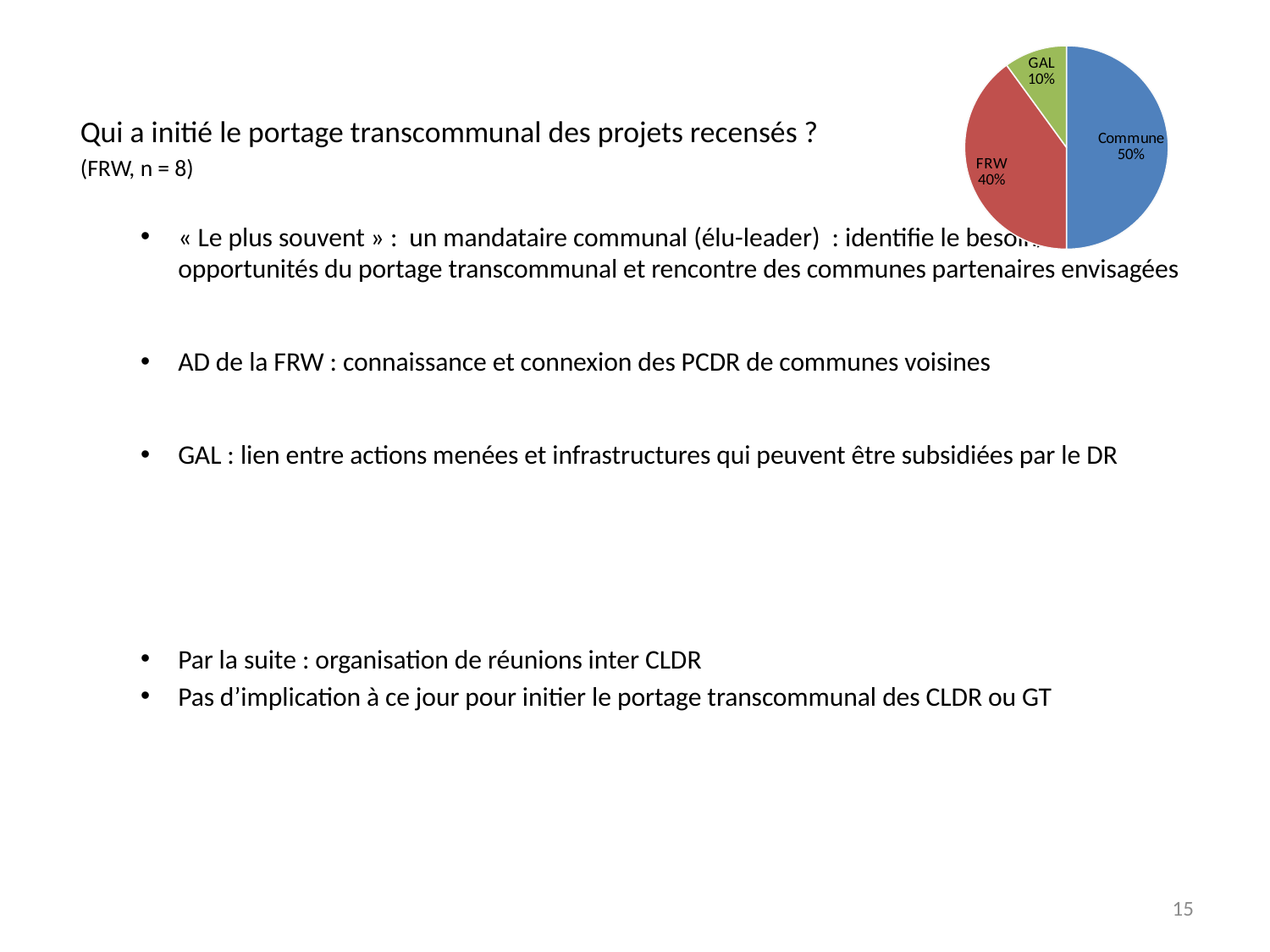
What kind of chart is shown on the slide? pie chart What is the difference in percentage points between the FRW slice and the GAL slice? 30 What share of the pie does GAL have? 10% Which is larger, the FRW slice or the GAL slice? FRW How many slices does the pie chart have? 3 What colour is the GAL slice of the pie? green What is the difference in percentage points between the Commune slice and the FRW slice? 10 What colour is the Commune slice of the pie? blue Which slice of the pie is the largest? Commune What share of the pie does Commune have? 50% Which slice of the pie is the smallest? GAL What share of the pie does FRW have? 40%